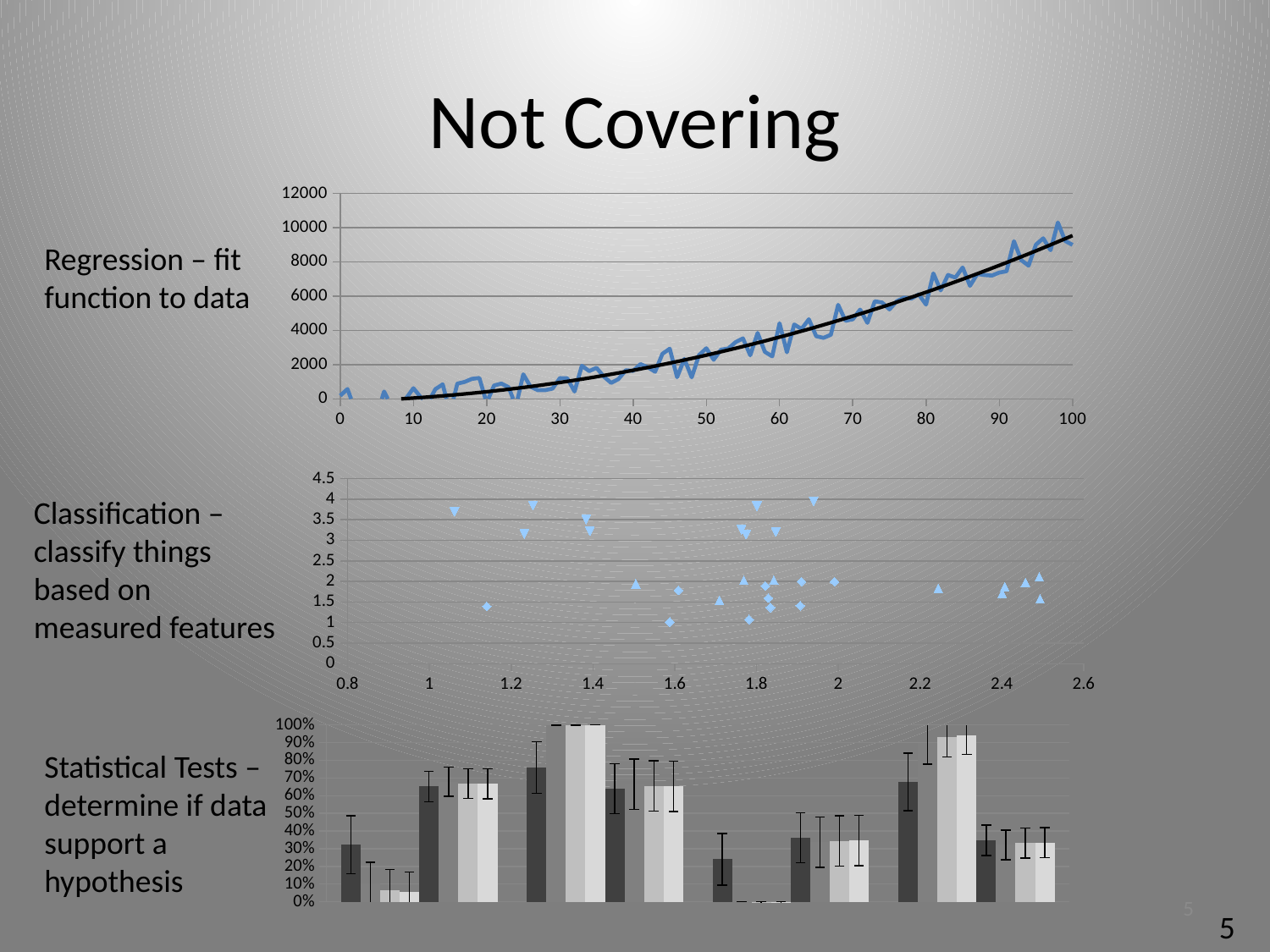
What kind of chart is the top chart on the slide (next to 'Regression – fit function to data')? line chart In the top chart (regression), is the value at x = 100 greater or less than 8000? greater In the top chart (regression), do the values rise or fall as x increases from 0 to 100? rise In the top chart (regression), is the value at x = 20 greater or less than 2000? less In the bottom chart (statistical tests), what is the highest value shown on the y axis? 100% In the top chart (regression), is the value at x = 60 greater or less than 6000? less What kind of chart is the middle chart on the slide (next to 'Classification')? scatter chart What kind of chart is the bottom chart on the slide (next to 'Statistical Tests')? bar chart In the top chart (regression), what is the highest value shown on the y axis? 12000